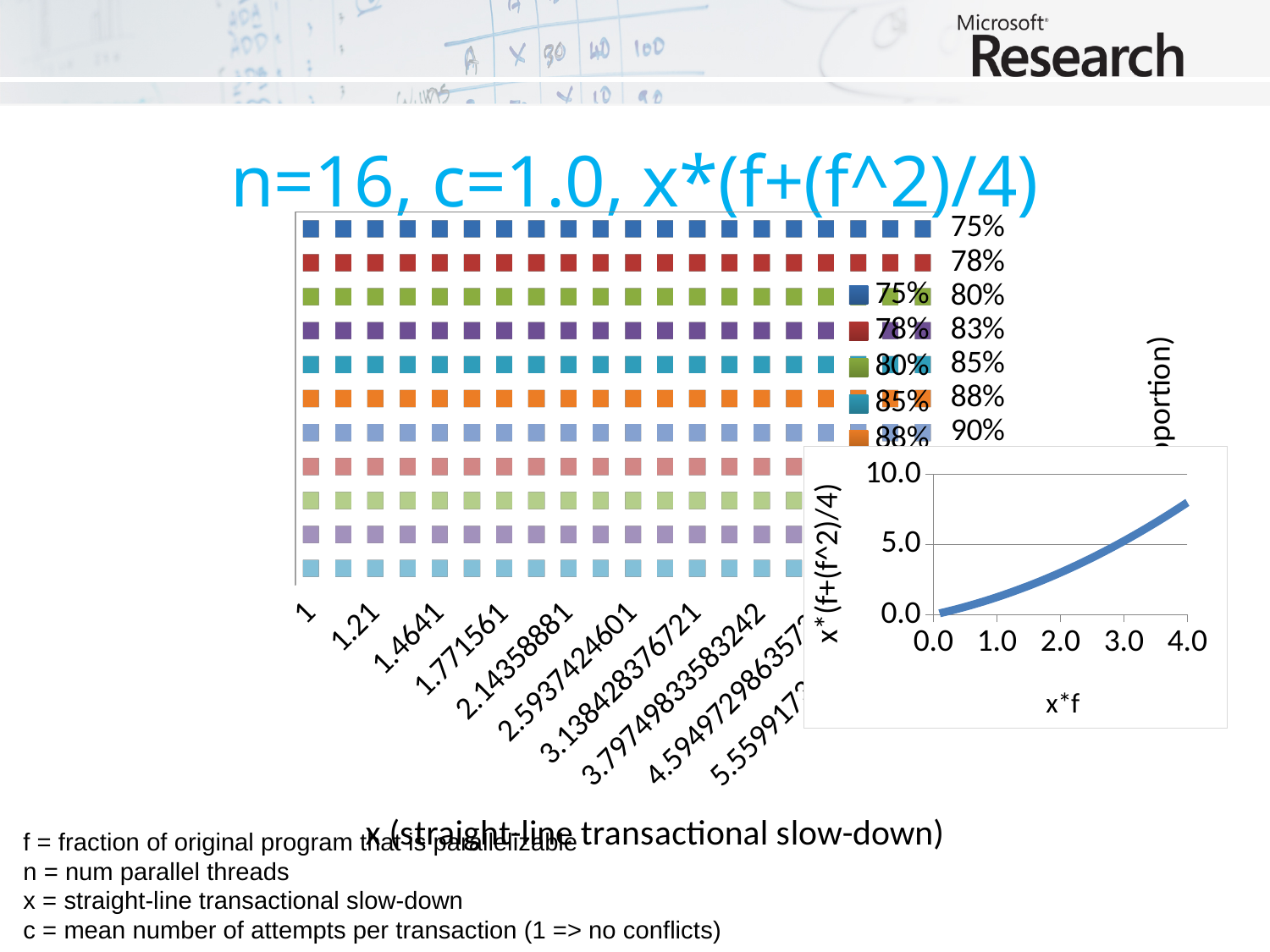
In the inset chart, does the plotted line rise or fall as x*f increases from 0.0 to 4.0? rises What is the highest tick value shown on the y-axis of the inset chart? 10.0 How many rows of markers (series) are plotted in the large chart? 11 What is the second x-axis label on the large chart? 1.21 What is the x-axis title of the inset chart? x*f In the inset chart, is the value of the line at x*f = 4.0 greater or less than 5.0? greater In the inset chart, is the value of the line at x*f = 2.0 greater or less than 5.0? less What kind of chart is the small inset chart in the lower right? line chart What is the first (leftmost) x-axis label on the large chart? 1 What is the title of the large chart on the slide? n=16, c=1.0, x*(f+(f^2)/4) In the inset chart, is the value of the line at x*f = 1.0 greater or less than 5.0? less